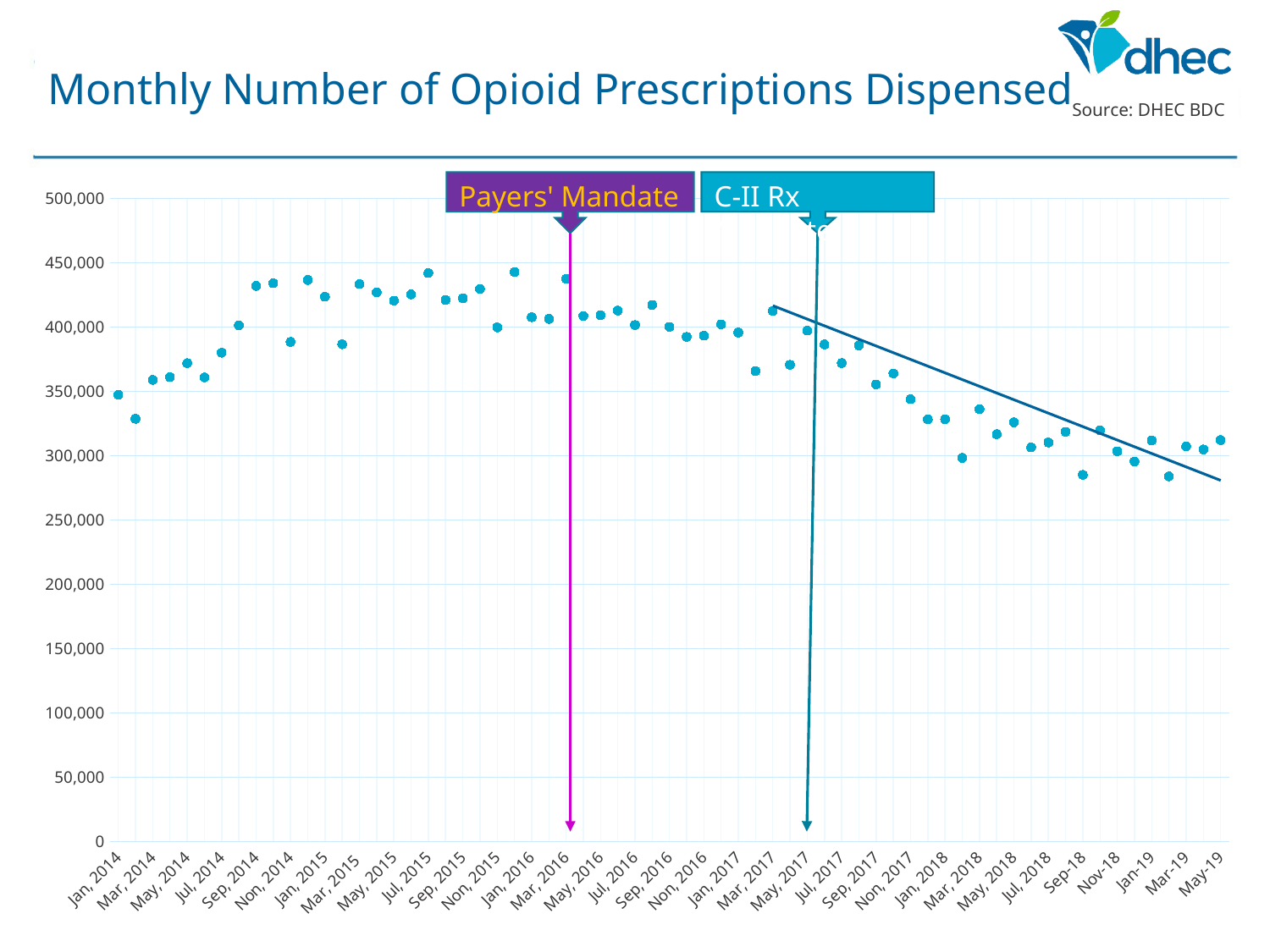
What kind of chart is shown on the slide? scatter chart Is the value for Mar, 2014 greater or less than 350,000? greater Is the value for Mar-19 greater or less than 300,000? greater Is the value for Sep, 2014 greater or less than 450,000? less What is the title of the chart? Monthly Number of Opioid Prescriptions Dispensed What source is cited for the chart data? DHEC BDC Do the values generally rise or fall from Mar, 2017 to May-19? fall Do the values generally rise or fall from Jan, 2014 to Sep, 2014? rise